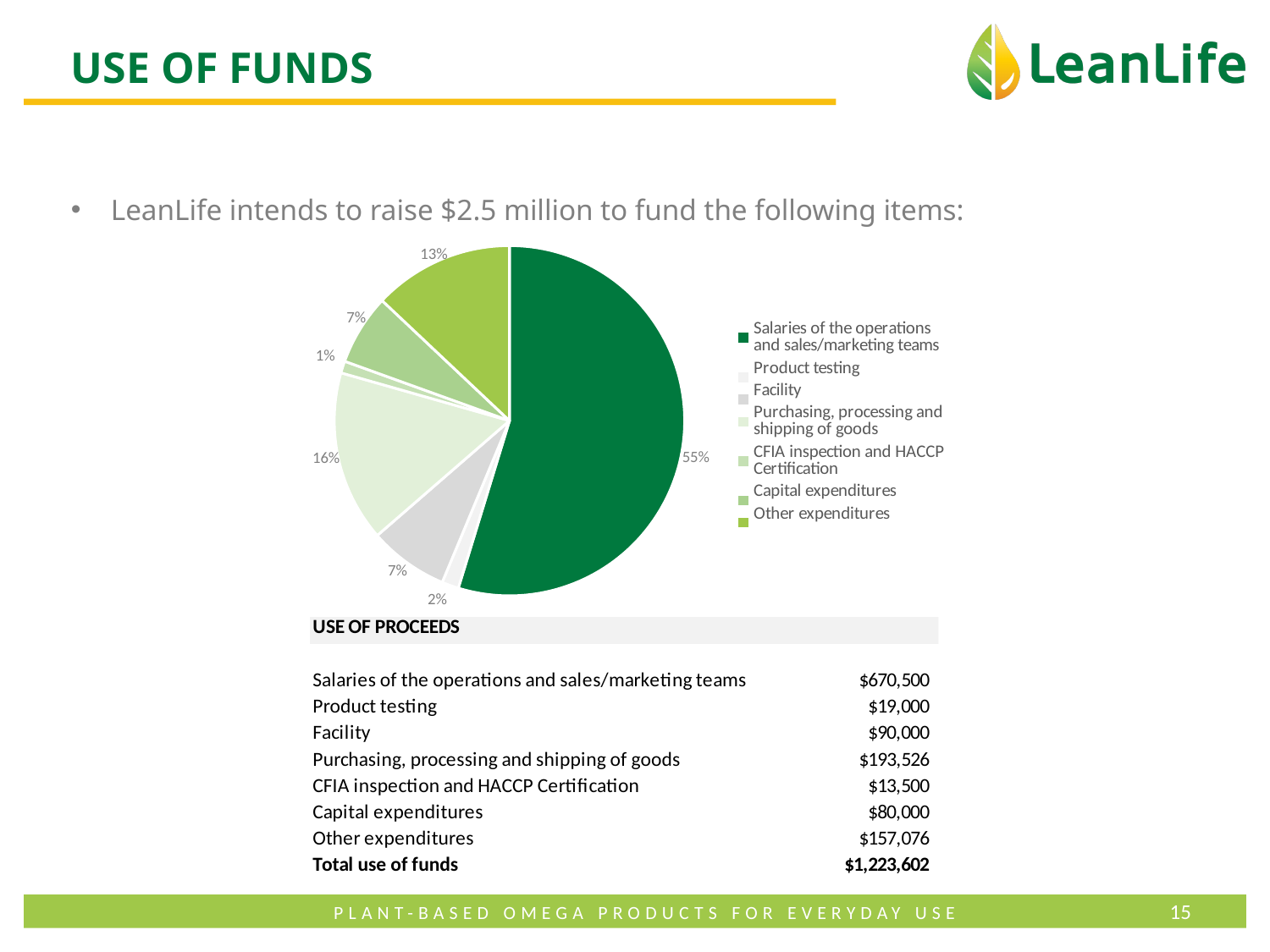
What type of chart is shown on the slide? pie chart How many entries does the legend list? 7 What share of the pie does 'CFIA inspection and HACCP Certification' represent? 1% Which category has the largest slice of the pie? Salaries of the operations and sales/marketing teams Which category has the smallest slice of the pie? CFIA inspection and HACCP Certification What share of the pie does 'Purchasing, processing and shipping of goods' represent? 16% What share of the pie does 'Salaries of the operations and sales/marketing teams' represent? 55% Which is larger: the slice for 'Purchasing, processing and shipping of goods' or the slice for 'Other expenditures'? Purchasing, processing and shipping of goods What is the difference in percentage points between the 'Salaries of the operations and sales/marketing teams' slice and the 'Purchasing, processing and shipping of goods' slice? 39 percentage points How many slices does the pie chart have? 7